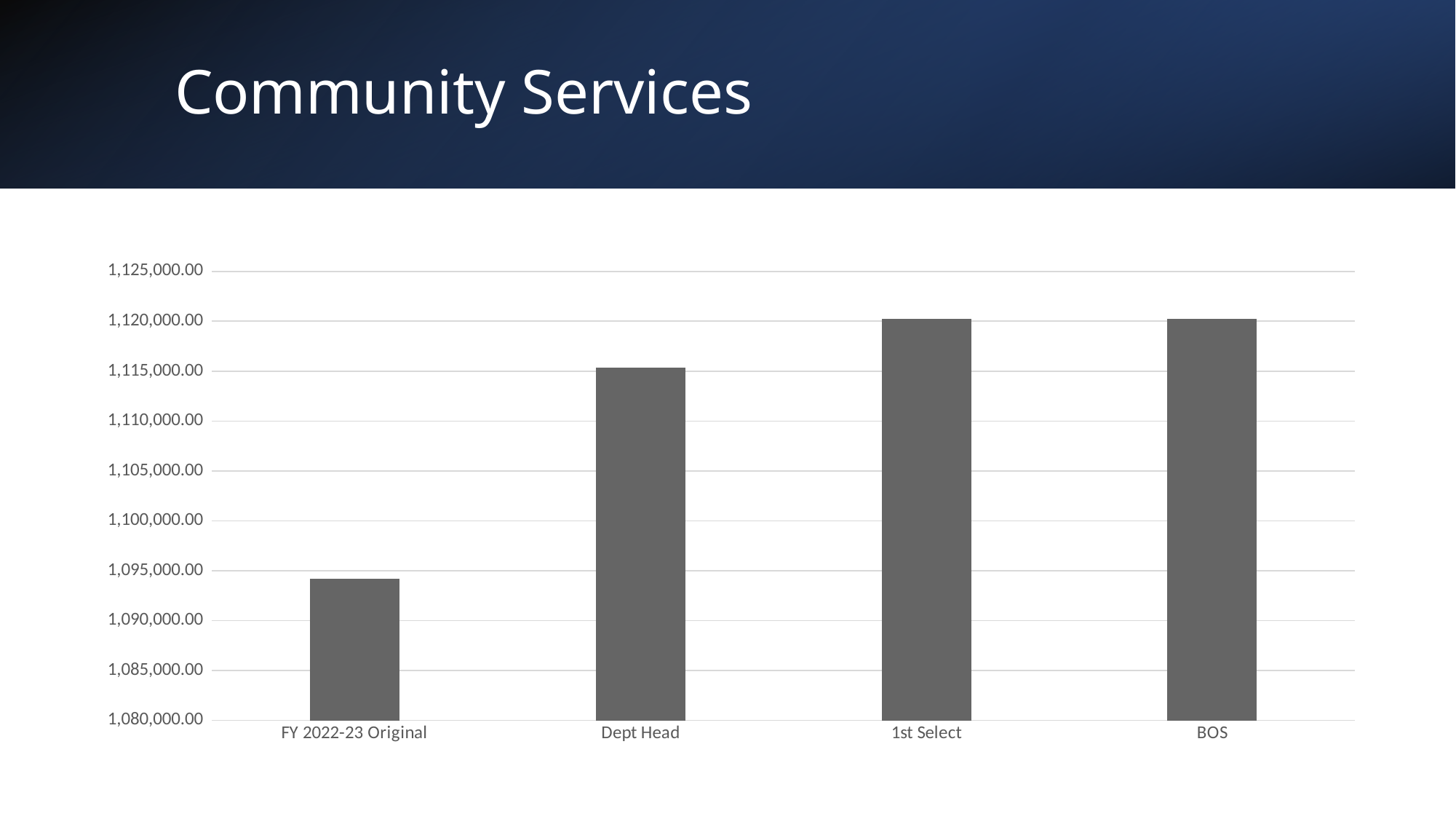
Do the values generally rise or fall from left to right along the x axis? rise Is the value for BOS greater or less than 1,125,000.00? less Which is larger, the value for Dept Head or the value for FY 2022-23 Original? Dept Head Which category has the lowest value? FY 2022-23 Original Is the value for 1st Select greater or less than 1,115,000.00? greater Which is larger, the value for 1st Select or the value for Dept Head? 1st Select How many categories are plotted on the x axis? 4 What is the title shown above the chart on the slide? Community Services Is the value for Dept Head greater or less than 1,110,000.00? greater What kind of chart is shown on the slide? bar chart